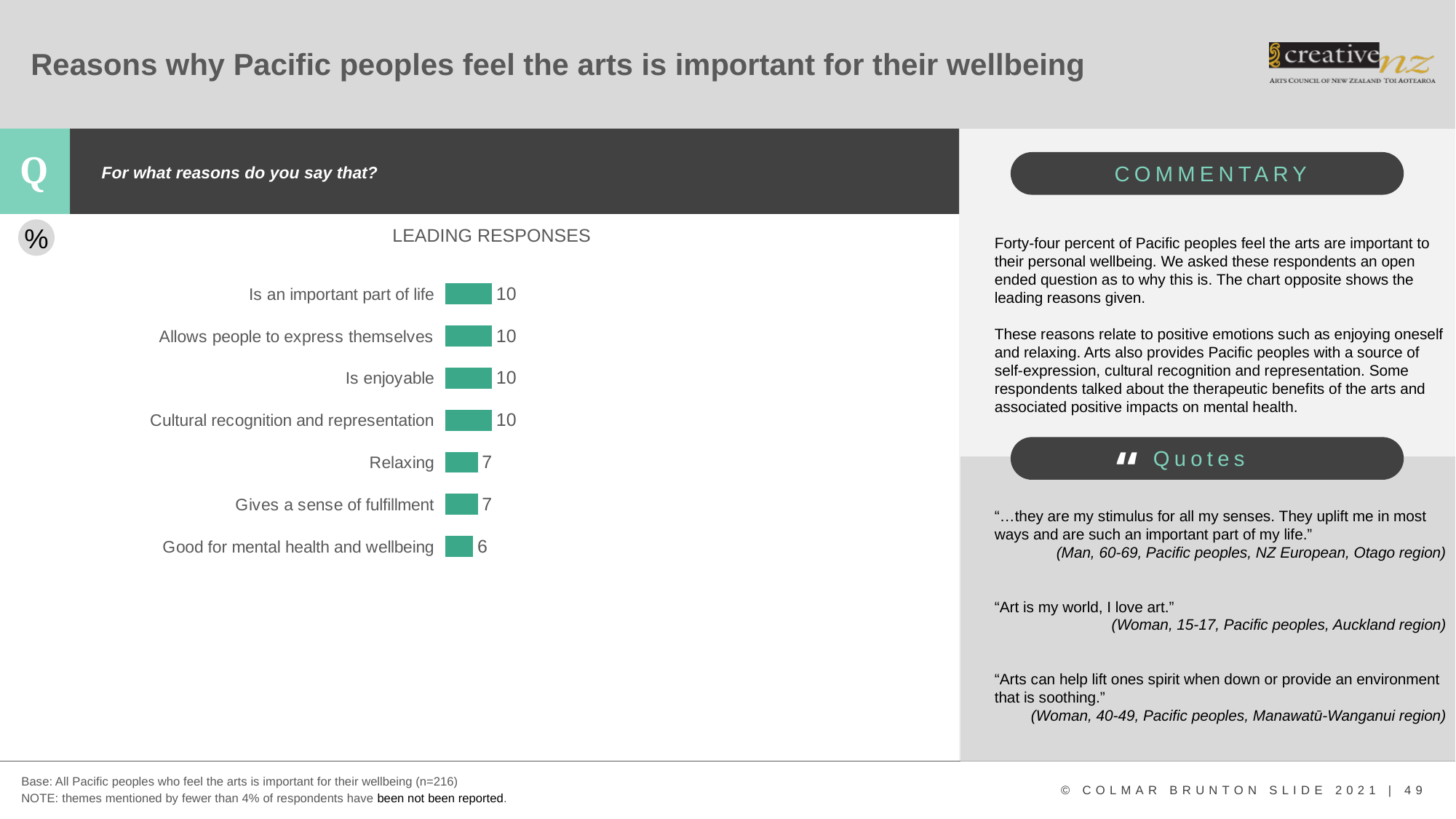
Which category has the lowest value? Good for mental health and wellbeing What is the difference between the values for "Gives a sense of fulfillment" and "Good for mental health and wellbeing"? 1 How many categories have a value of 10? 4 What is the value for "Good for mental health and wellbeing"? 6 How many categories are shown in the chart? 7 What is the difference between the values for "Is enjoyable" and "Relaxing"? 3 Which is larger, the value for "Allows people to express themselves" or the value for "Relaxing"? Allows people to express themselves What kind of chart is shown on the slide? Bar chart What is the value for "Gives a sense of fulfillment"? 7 What is the title of the chart? LEADING RESPONSES What is the value for "Relaxing"? 7 What is the value for "Cultural recognition and representation"? 10